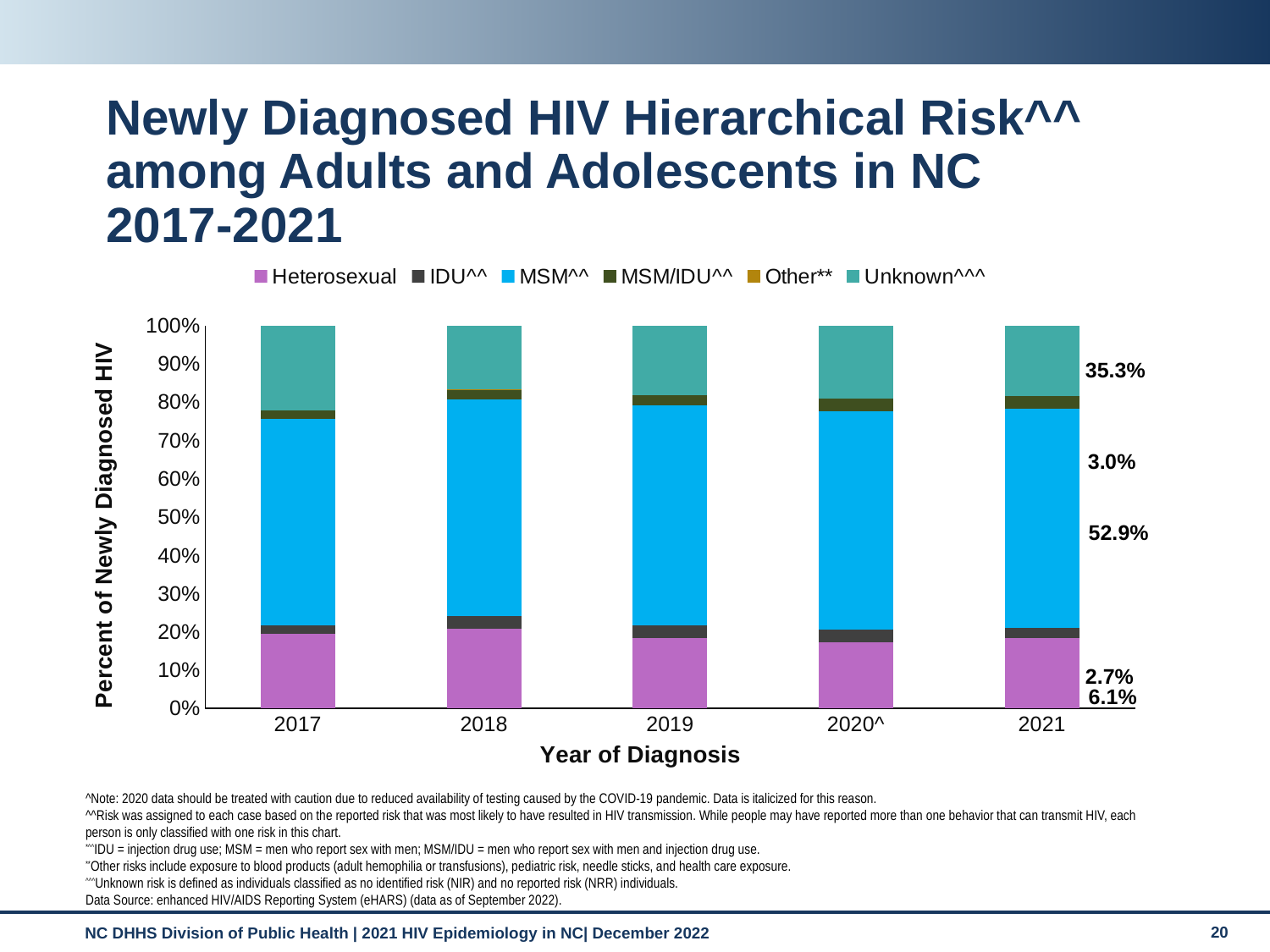
What kind of chart is shown on the slide? Stacked bar chart In 2021, which is larger: the MSM^^ share or the Unknown^^^ share? MSM^^ Which risk category accounts for the largest share of newly diagnosed HIV in 2021? MSM^^ How many years of diagnosis are shown on the x axis? 5 How many series does the legend list? 6 Is the Heterosexual share for 2020^ greater or less than 20%? less